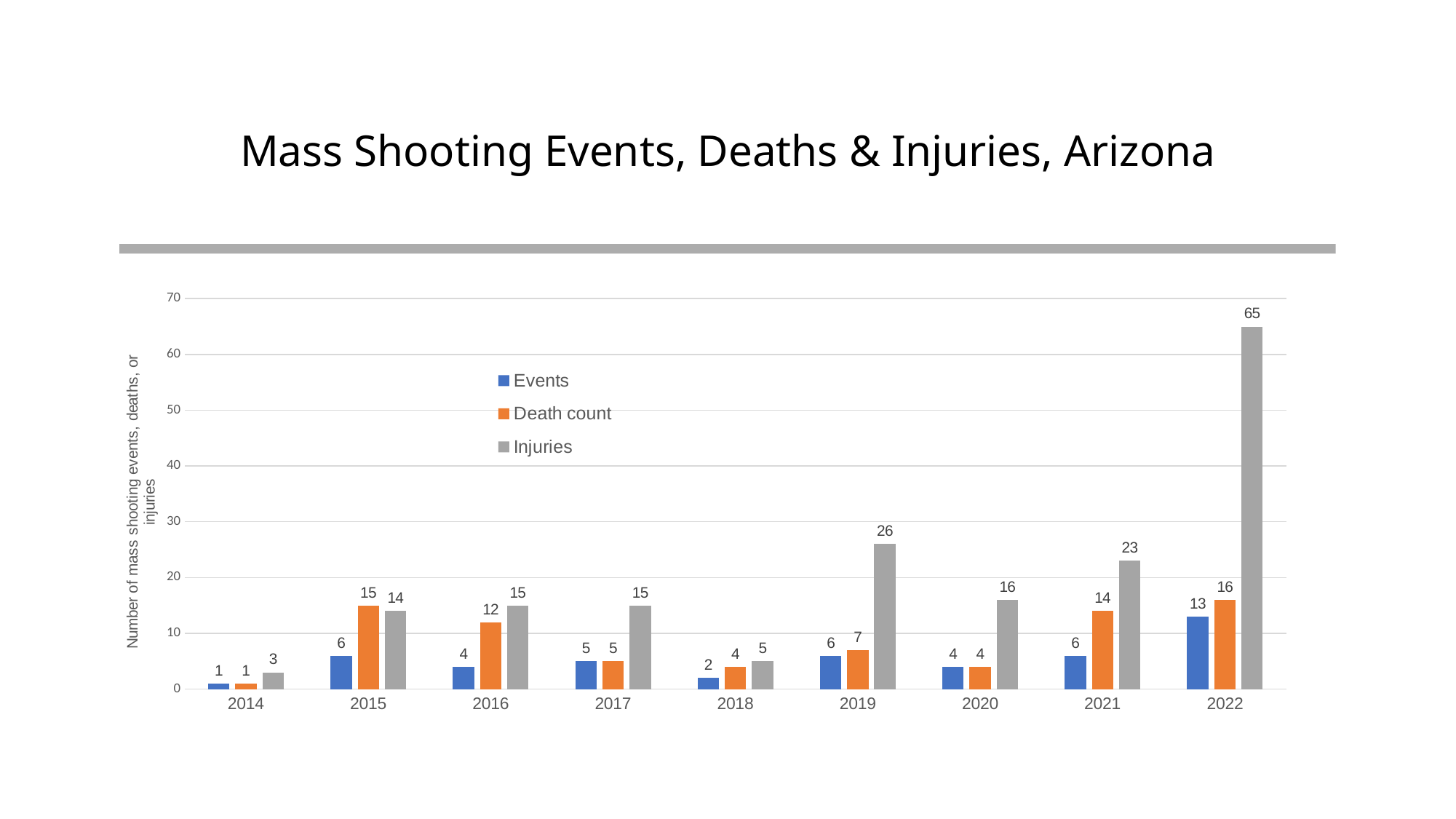
What is the death count for 2016? 12 What is the number of injuries in 2022? 65 How many series does the legend list? 3 What kind of chart is shown on the slide? Bar chart How many events are shown for 2021? 6 What is the title of the chart? Mass Shooting Events, Deaths & Injuries, Arizona How many years are shown on the x axis? 9 Is the value for injuries in 2022 greater or less than 60? greater What is the difference between the injuries in 2022 and the injuries in 2019? 39 Which is larger, the death count in 2015 or the death count in 2021? Death count in 2015 Which year has the highest number of injuries? 2022 Which year has the lowest number of events? 2014